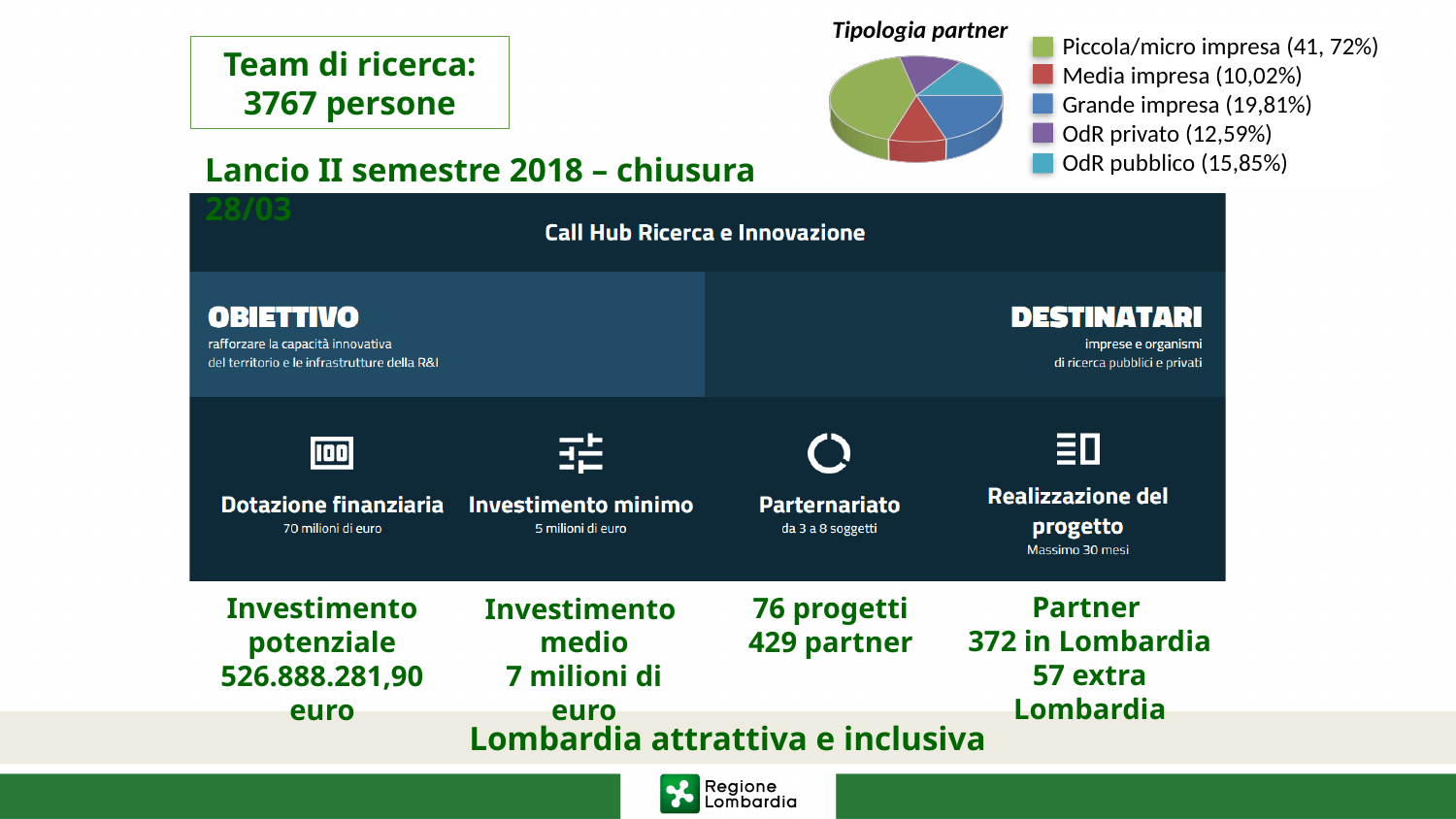
In the 'Tipologia partner' chart, what is the difference in percentage points between Grande impresa and OdR pubblico? 3,96 In the 'Tipologia partner' chart, what percentage is shown for Media impresa? 10,02% In the 'Tipologia partner' chart, which partner type has the largest share? Piccola/micro impresa What is the title of the pie chart on the slide? Tipologia partner In the 'Tipologia partner' chart, what percentage is shown for Grande impresa? 19,81% In the 'Tipologia partner' chart, which partner type has the smallest share? Media impresa In the 'Tipologia partner' chart, what percentage is shown for OdR privato? 12,59% In the 'Tipologia partner' chart, what is the difference in percentage points between OdR pubblico and OdR privato? 3,26 In the 'Tipologia partner' chart, which has a larger share: Grande impresa or OdR pubblico? Grande impresa In the 'Tipologia partner' chart, what percentage is shown for OdR pubblico? 15,85% What kind of chart is the 'Tipologia partner' chart? pie chart How many partner types are shown in the 'Tipologia partner' chart? 5